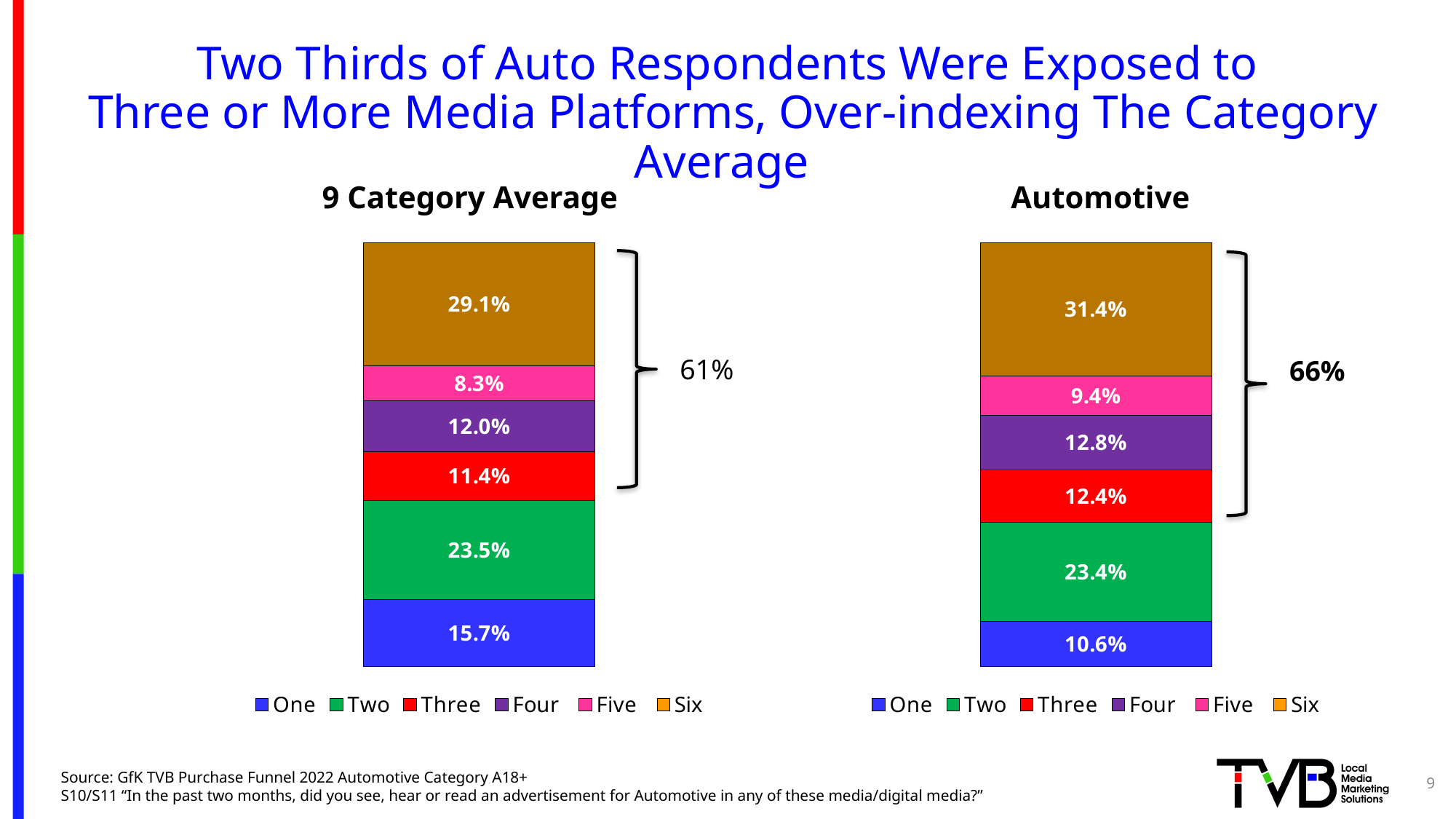
In the 9 Category Average chart, what is the value for the Five segment? 8.3% What kind of chart is the 9 Category Average chart? Stacked bar chart In the 9 Category Average chart, what is the value for the Six segment? 29.1% What is the difference between the Six segment in the Automotive chart and the Six segment in the 9 Category Average chart? 2.3% In the Automotive chart, which segment has the largest value? Six In the 9 Category Average chart, which segment has the smallest value? Five In the Automotive chart, what is the value for the Four segment? 12.8% In the Automotive chart, what is the value for the One segment? 10.6% Which is larger: the One segment in the 9 Category Average chart or the One segment in the Automotive chart? 9 Category Average How many series does the legend of the Automotive chart list? 6 What percentage is shown next to the bracket on the Automotive chart? 66% What percentage is shown next to the bracket on the 9 Category Average chart? 61%